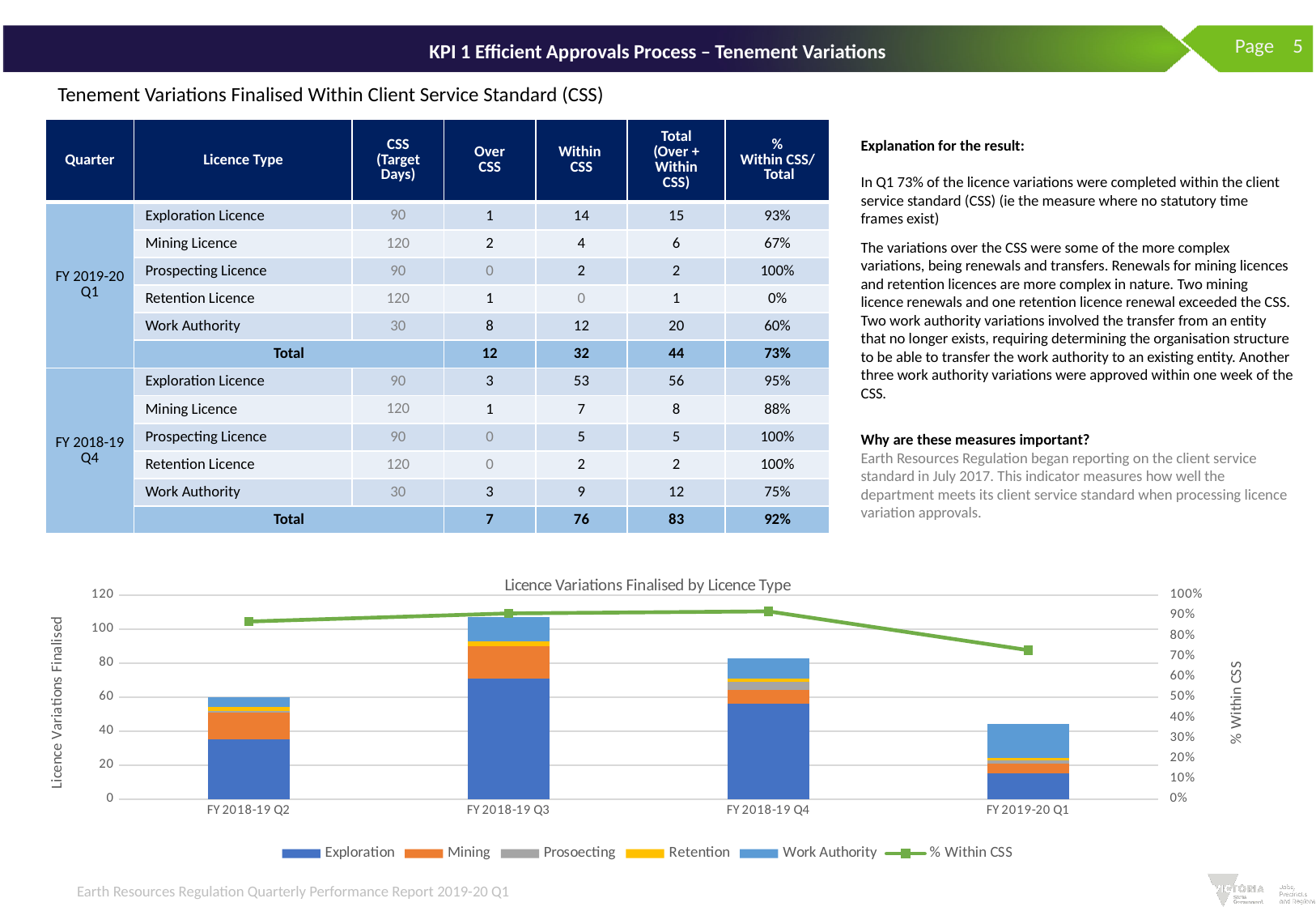
Which stacked bar is taller, FY 2018-19 Q3 or FY 2018-19 Q4? FY 2018-19 Q3 What kind of chart is shown on the slide? Stacked bar chart with a line What is the title of the chart at the bottom of the slide? Licence Variations Finalised by Licence Type How many series does the chart legend list? 6 Is the % Within CSS value for FY 2019-20 Q1 greater or less than 80%? less Does the % Within CSS line rise or fall from FY 2018-19 Q4 to FY 2019-20 Q1? falls What is the label of the right-hand vertical axis of the chart? % Within CSS Is the total stacked bar for FY 2019-20 Q1 greater or less than 60? less Which quarter has the shortest stacked bar in the chart? FY 2019-20 Q1 Which quarter has the tallest stacked bar in the chart? FY 2018-19 Q3 How many quarters are shown on the x axis of the chart? 4 Is the total stacked bar for FY 2018-19 Q3 greater or less than 100? greater